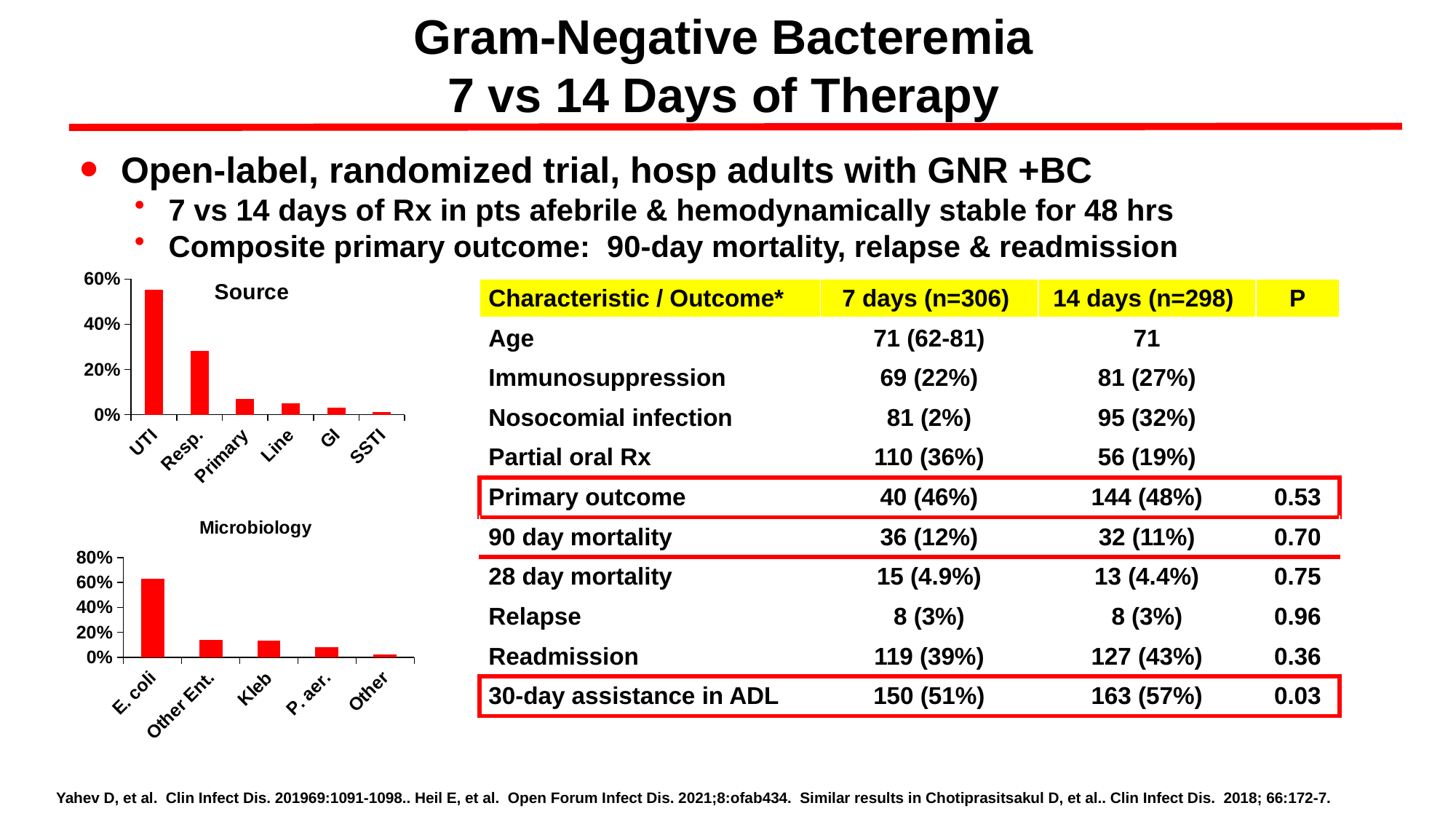
In the Source chart, which is larger, the value for Resp. or the value for Primary? Resp. How many categories are shown in the Microbiology chart? 5 How many categories are shown in the Source chart? 6 In the Source chart, which category has the lowest value? SSTI What kind of chart is the Microbiology chart? bar chart In the Source chart, is the value for Resp. greater or less than 40%? less In the Source chart, which category has the highest value? UTI In the Source chart, is the value for UTI greater or less than 40%? greater In the Microbiology chart, which category has the highest value? E. coli Do the values in the Source chart rise or fall from left to right along the x axis? fall In the Microbiology chart, which category has the lowest value? Other